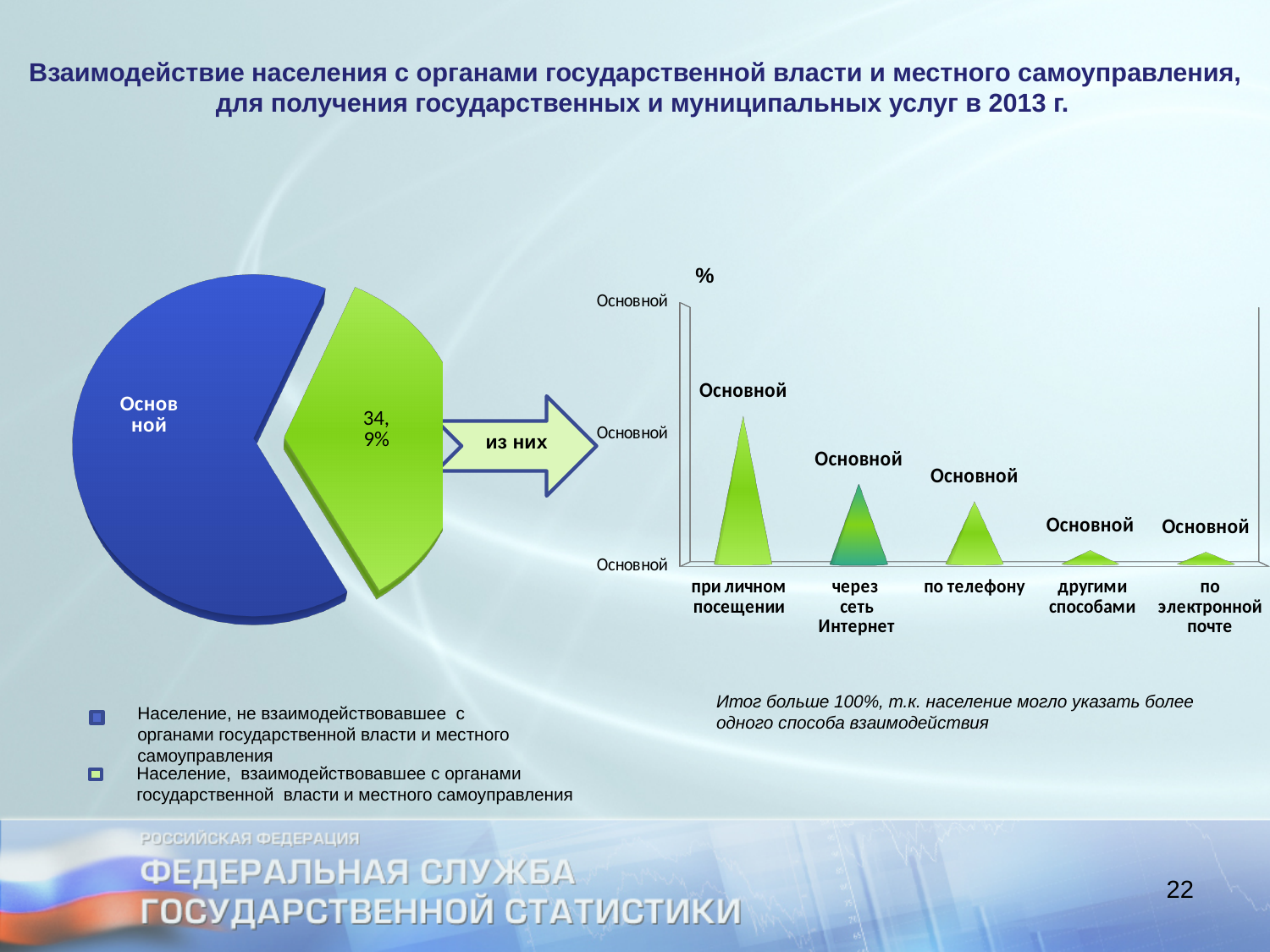
How many entries does the legend below the pie chart list? 2 On the chart on the right, which category has the highest value? при личном посещении On the chart on the right, which is larger: the value for 'при личном посещении' or the value for 'по телефону'? при личном посещении What kind of chart is the chart on the left of the slide? pie chart On the pie chart, what value is printed on the green slice? 34,9% On the chart on the right, which is larger: the value for 'через сеть Интернет' or the value for 'по телефону'? через сеть Интернет On the chart on the right, what unit is shown at the top of the vertical axis? % How many slices does the pie chart have? 2 What text is written inside the arrow between the pie chart and the chart on the right? из них On the chart on the right, how many categories are shown along the x axis? 5 On the pie chart, which slice is larger, the blue one or the green one? the blue one On the pie chart, what share does the slice for the population that interacted with state and local government bodies (Население, взаимодействовавшее с органами государственной власти и местного самоуправления) have? 34,9%